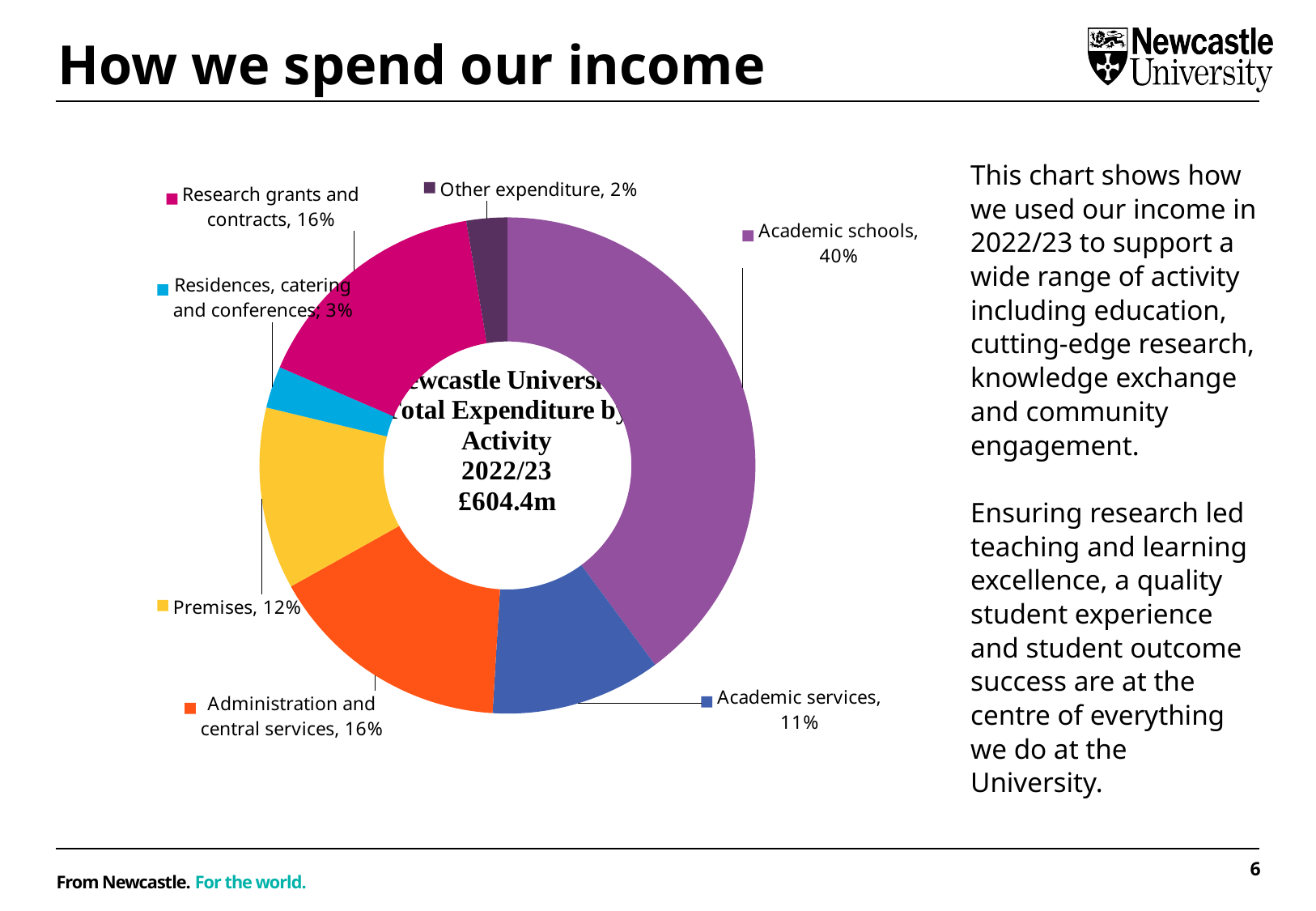
Which category has the largest share of expenditure? Academic schools What share of expenditure goes to Residences, catering and conferences? 3% Which category has the smallest share of expenditure? Other expenditure Which is larger, the share for Premises or the share for Academic services? Premises What share of expenditure goes to Academic schools? 40% What total expenditure figure is shown in the centre of the chart? £604.4m What share of expenditure goes to Academic services? 11% What colour is the Academic schools segment? Purple What share of expenditure goes to Premises? 12% What kind of chart is shown on the slide? Doughnut (pie) chart How many categories are shown in the chart? 7 What is the difference in percentage points between Academic schools and Administration and central services? 24